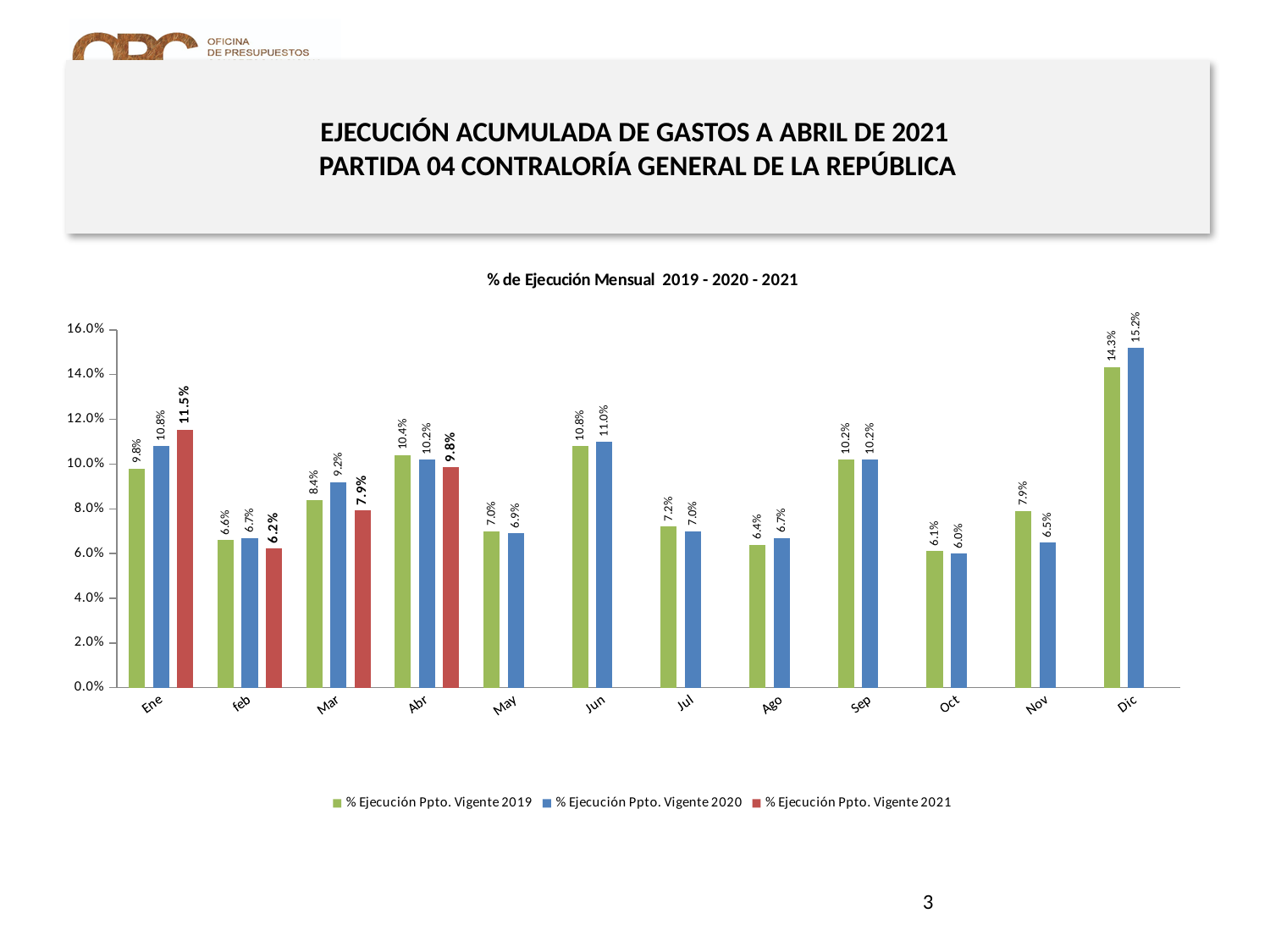
What is the difference between the 2020 and 2019 values in Dic? 0.9% What is the value for % Ejecución Ppto. Vigente 2021 in Ene? 11.5% Which is larger in Mar: the 2020 value or the 2021 value? 2020 (9.2%) What is the title of the chart? % de Ejecución Mensual 2019 - 2020 - 2021 How many months are shown on the x axis? 12 What is the value for % Ejecución Ppto. Vigente 2020 in Dic? 15.2% How many series does the legend list? 3 Which month has the lowest value for % Ejecución Ppto. Vigente 2021? feb Is the value for % Ejecución Ppto. Vigente 2019 in Jun greater or less than 10.0%? greater Which month has the highest value for % Ejecución Ppto. Vigente 2019? Dic What kind of chart is shown on the slide? Bar chart What is the value for % Ejecución Ppto. Vigente 2019 in Abr? 10.4%